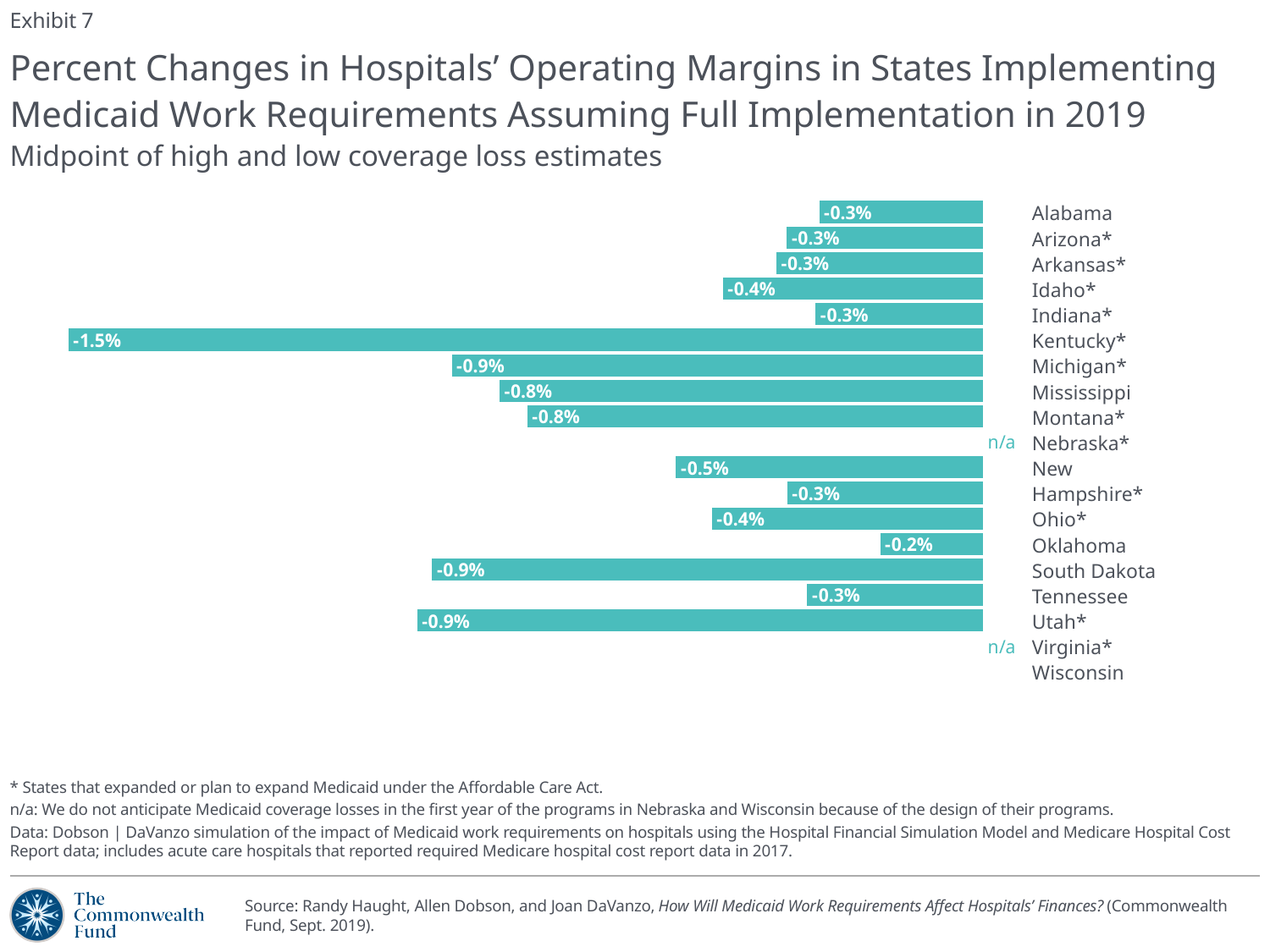
Which two states are shown as n/a in the chart? Nebraska and Wisconsin What is the subtitle of the chart? Midpoint of high and low coverage loss estimates Which state has a larger decline in operating margin, Idaho or Mississippi? Mississippi What is the percent change in hospitals' operating margin for Kentucky? -1.5% Which state shows the largest decline in hospitals' operating margin? Kentucky What is the percent change in hospitals' operating margin for South Dakota? -0.2% What is the percent change in hospitals' operating margin for Michigan? -0.9% How many states are listed in the chart? 18 What is the difference in percentage points between the values for Kentucky and Michigan? 0.6 percentage points What is the percent change in hospitals' operating margin for New Hampshire? -0.5% Which state with a plotted value shows the smallest decline in hospitals' operating margin? South Dakota What type of chart is shown on the slide? Bar chart